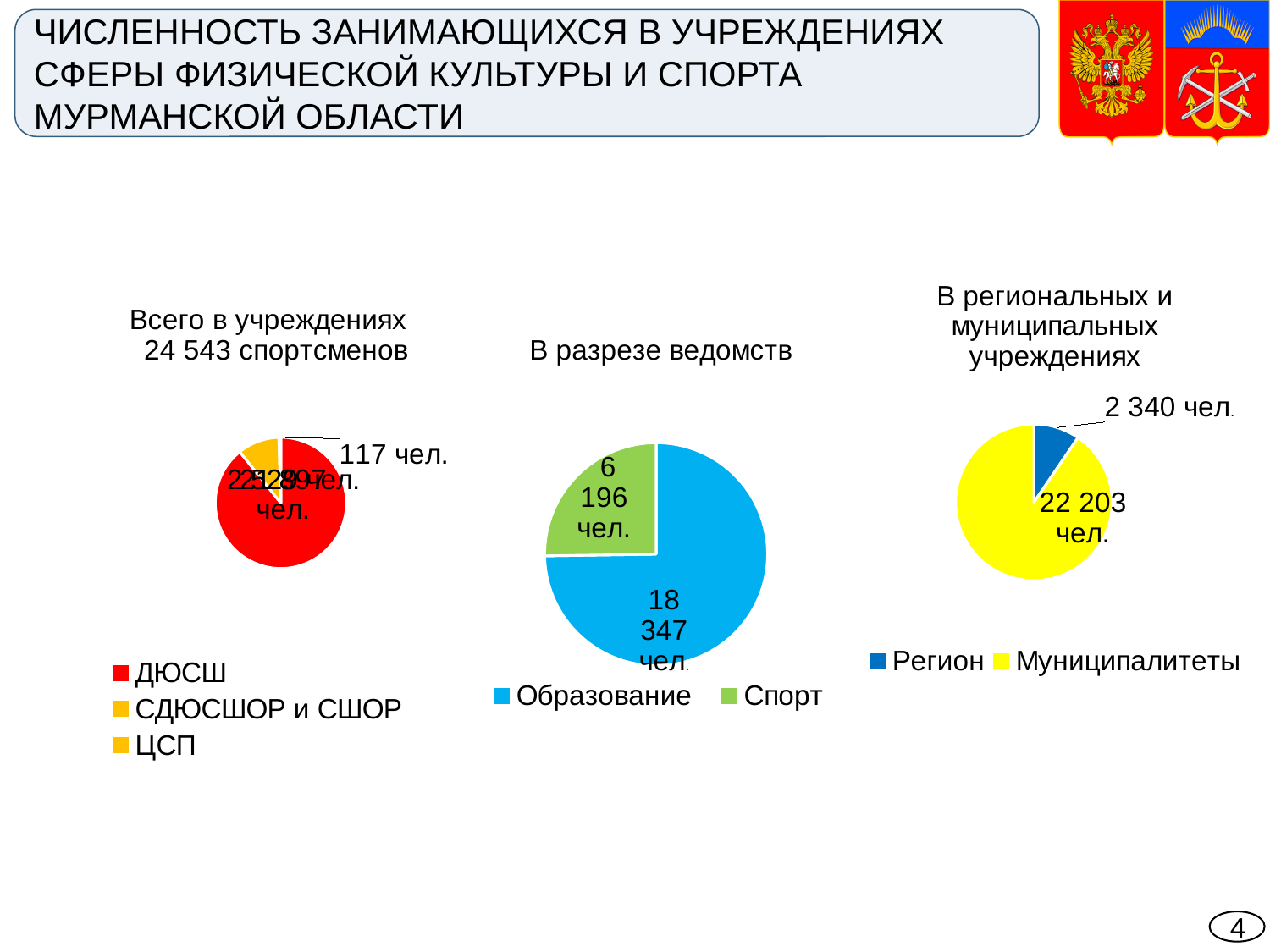
In the chart titled "В разрезе ведомств", what is the value for Образование? 18 347 чел. In the chart titled "В региональных и муниципальных учреждениях", what is the value for Муниципалитеты? 22 203 чел. In the chart titled "Всего в учреждениях 24 543 спортсменов", which category is the largest? ДЮСШ In the chart titled "В региональных и муниципальных учреждениях", which category is the largest? Муниципалитеты In the chart titled "В региональных и муниципальных учреждениях", what is the difference between the values for Муниципалитеты and Регион? 19 863 чел. How many categories does the legend of the chart titled "В разрезе ведомств" list? 2 In the chart titled "В разрезе ведомств", what is the value for Спорт? 6 196 чел. In the chart titled "В разрезе ведомств", which category has the larger value, Образование or Спорт? Образование What kind of chart is used in the chart titled "В разрезе ведомств"? pie chart In the chart titled "В региональных и муниципальных учреждениях", what is the value for Регион? 2 340 чел. How many categories does the legend of the chart titled "Всего в учреждениях 24 543 спортсменов" list? 3 In the chart titled "В разрезе ведомств", what is the difference between the values for Образование and Спорт? 12 151 чел.